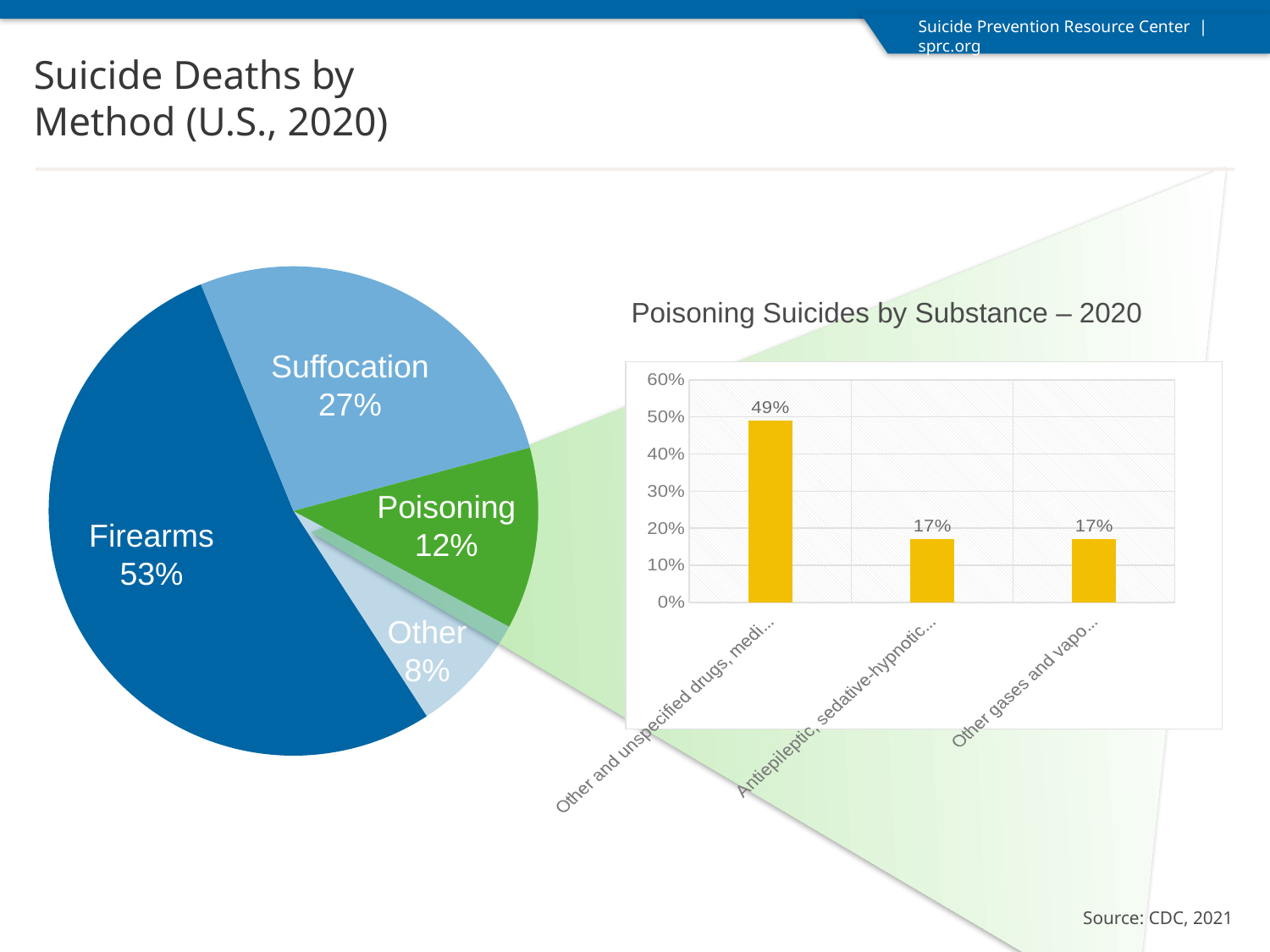
In the 'Poisoning Suicides by Substance – 2020' chart, what value is shown for the Antiepileptic, sedative-hypnotic bar? 17% What kind of chart is 'Poisoning Suicides by Substance – 2020'? Bar chart In the pie chart on the left, what is the difference in percentage points between Firearms and Suffocation? 26 In the pie chart on the left, what share of suicide deaths is attributed to Firearms? 53% In the 'Poisoning Suicides by Substance – 2020' chart, how many bars are plotted? 3 In the pie chart on the left, how many slices are shown? 4 In the 'Poisoning Suicides by Substance – 2020' chart, what is the difference between the first bar (Other and unspecified drugs) and the Other gases and vapors bar? 32 percentage points In the pie chart on the left, which method accounts for the largest share of suicide deaths? Firearms In the pie chart on the left, which is larger, Poisoning or Other? Poisoning In the 'Poisoning Suicides by Substance – 2020' chart, what value is shown for the first bar (Other and unspecified drugs)? 49% In the pie chart on the left, what percentage is shown for Suffocation? 27% In the pie chart on the left, which method has the smallest slice? Other